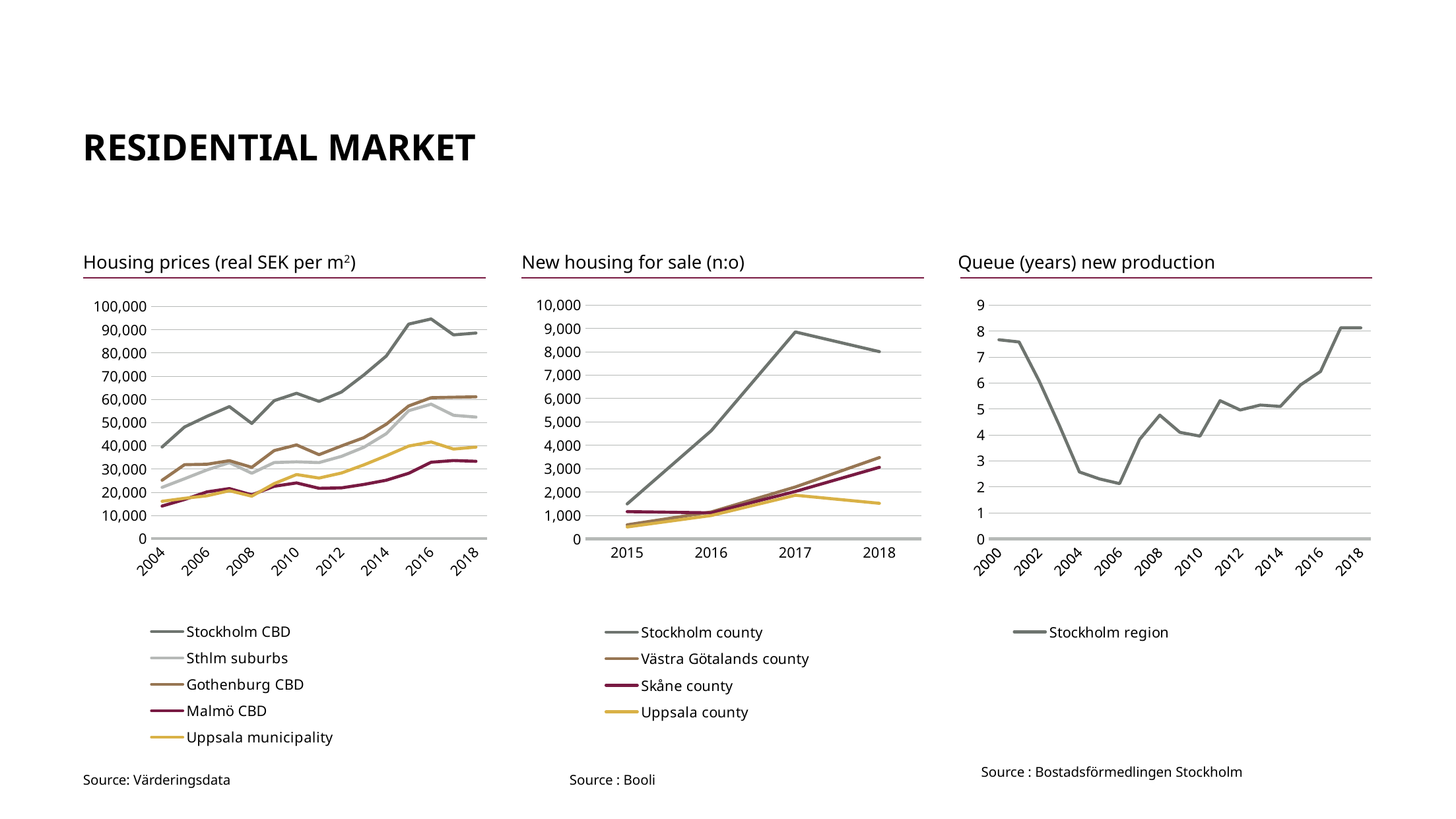
In the 'Housing prices (real SEK per m2)' chart, which is larger in 2018: Gothenburg CBD or Sthlm suburbs? Gothenburg CBD What kind of chart is the 'Housing prices (real SEK per m2)' chart? line chart How many series does the legend of the 'Housing prices (real SEK per m2)' chart list? 5 How many series does the legend of the 'New housing for sale (n:o)' chart list? 4 In the 'Queue (years) new production' chart, is the value for 2018 greater or less than 7? greater How many years are shown on the x axis of the 'New housing for sale (n:o)' chart? 4 In the 'New housing for sale (n:o)' chart, is the value for Stockholm county in 2017 greater or less than 8,000? greater In the 'Housing prices (real SEK per m2)' chart, do the Stockholm CBD values generally rise or fall from 2004 to 2018? rise In the 'Housing prices (real SEK per m2)' chart, is the value for Stockholm CBD in 2018 greater or less than 80,000? greater In the 'Housing prices (real SEK per m2)' chart, which series has the highest values throughout the period? Stockholm CBD In the 'Queue (years) new production' chart, which series does the legend list? Stockholm region